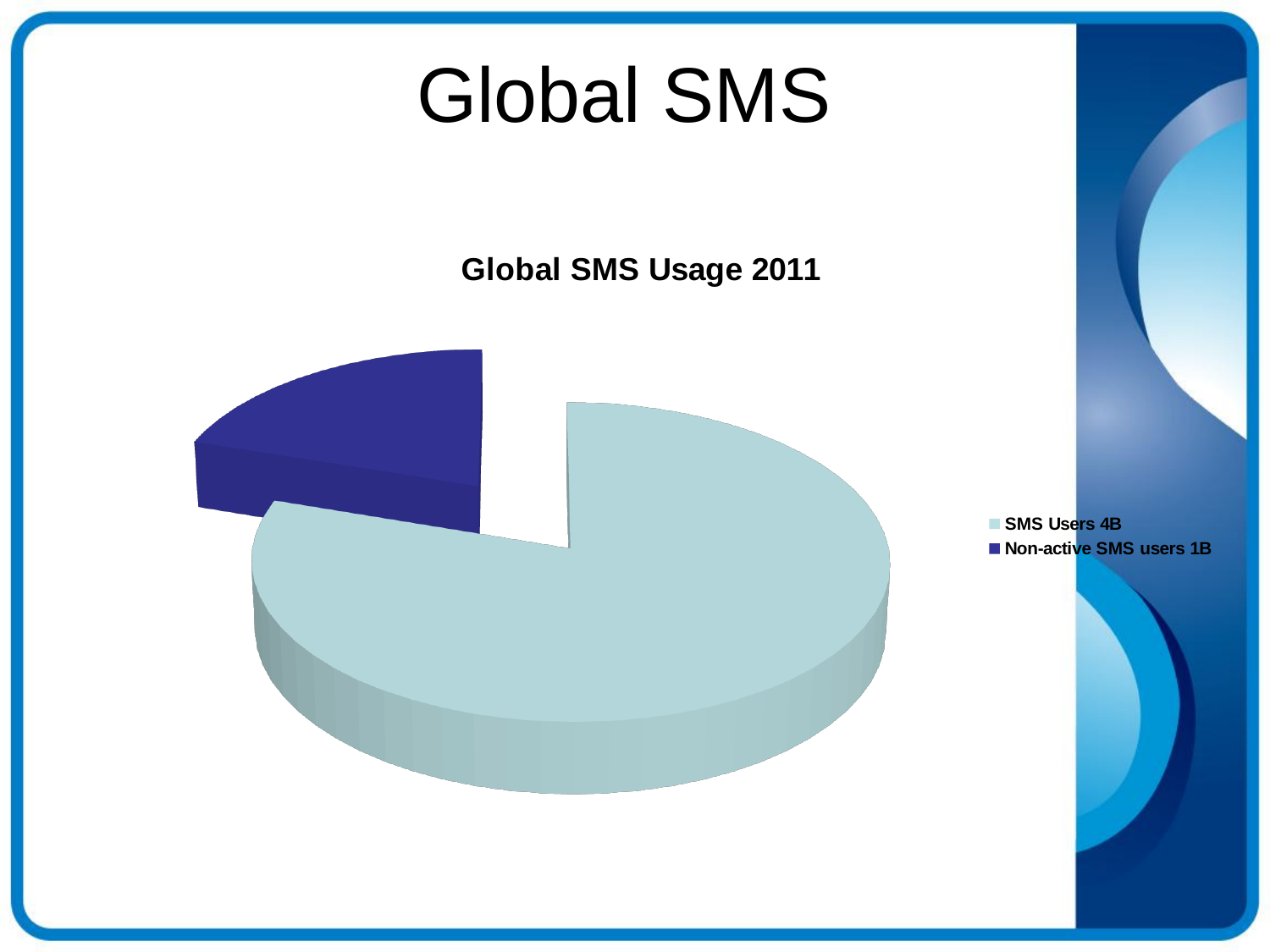
What colour is the Non-active SMS users slice? Dark blue Which slice is the largest in the pie chart? SMS Users 4B According to the legend, how many non-active SMS users are there? 1B Which is larger: the SMS Users slice or the Non-active SMS users slice? SMS Users What is the total of the two values shown in the legend? 5B How many slices does the pie chart have? 2 What is the title of the chart? Global SMS Usage 2011 According to the legend, how many SMS users are there? 4B Which slice is the smallest in the pie chart? Non-active SMS users 1B How many entries does the legend list? 2 What kind of chart is shown on the slide? Pie chart What is the difference between the SMS Users value and the Non-active SMS users value shown in the legend? 3B